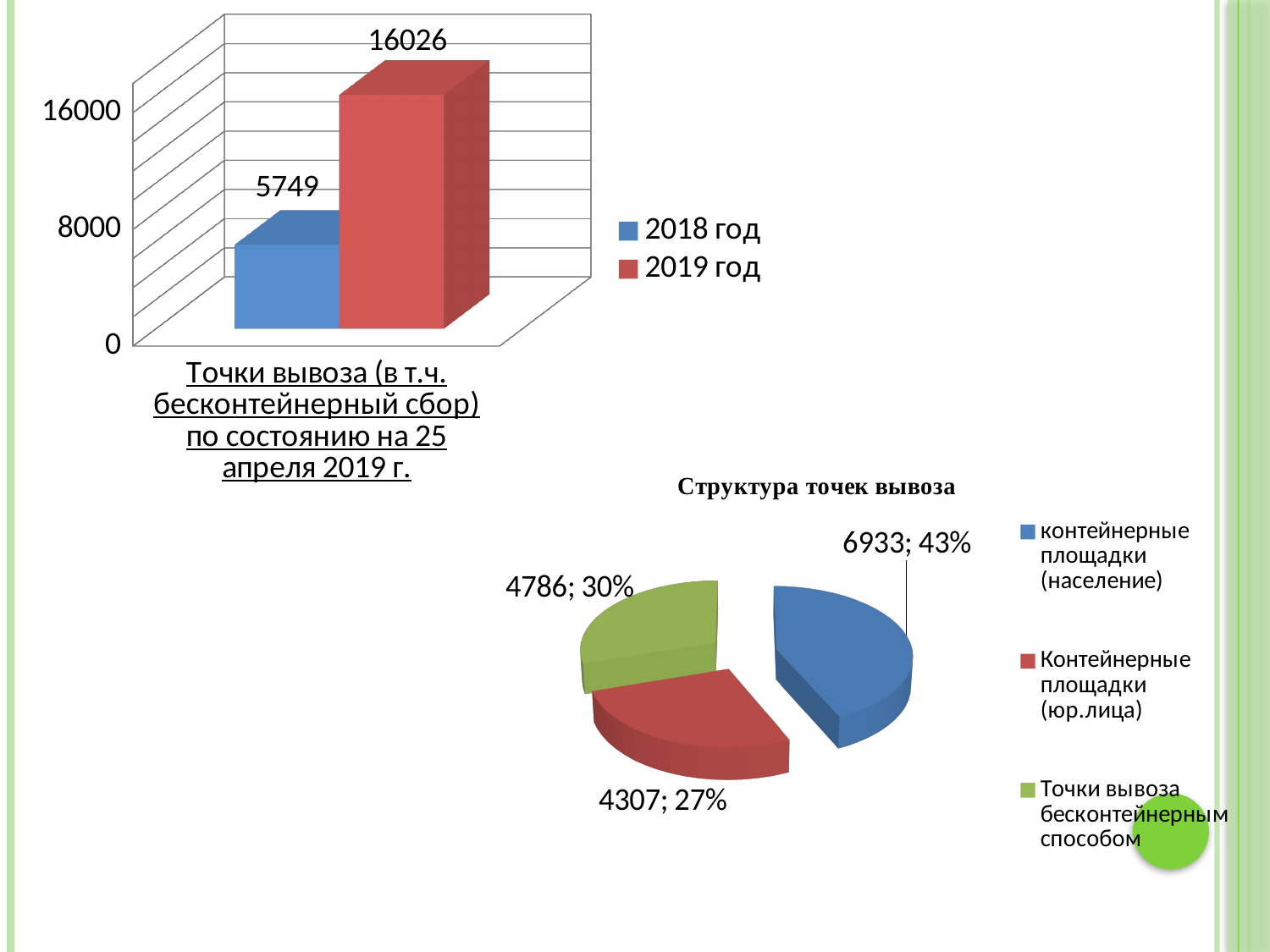
In the chart titled 'Структура точек вывоза', what is the value for 'контейнерные площадки (население)'? 6933 In the bar chart at the top left, what is the value for 2019 год? 16026 In the chart titled 'Структура точек вывоза', how many slices does the pie have? 3 In the bar chart at the top left, what is the difference between the 2019 год and 2018 год values? 10277 In the bar chart at the top left, how many series does the legend list? 2 What kind of chart is the chart titled 'Структура точек вывоза'? Pie chart In the bar chart at the top left, what is the value for 2018 год? 5749 What kind of chart is the chart at the top left of the slide? Bar chart In the bar chart at the top left, which series has the higher value, 2018 год or 2019 год? 2019 год In the chart titled 'Структура точек вывоза', which category has the smallest slice? Контейнерные площадки (юр.лица) In the chart titled 'Структура точек вывоза', what is the value for 'Контейнерные площадки (юр.лица)'? 4307 In the chart titled 'Структура точек вывоза', what share of the pie is 'Точки вывоза бесконтейнерным способом'? 30%